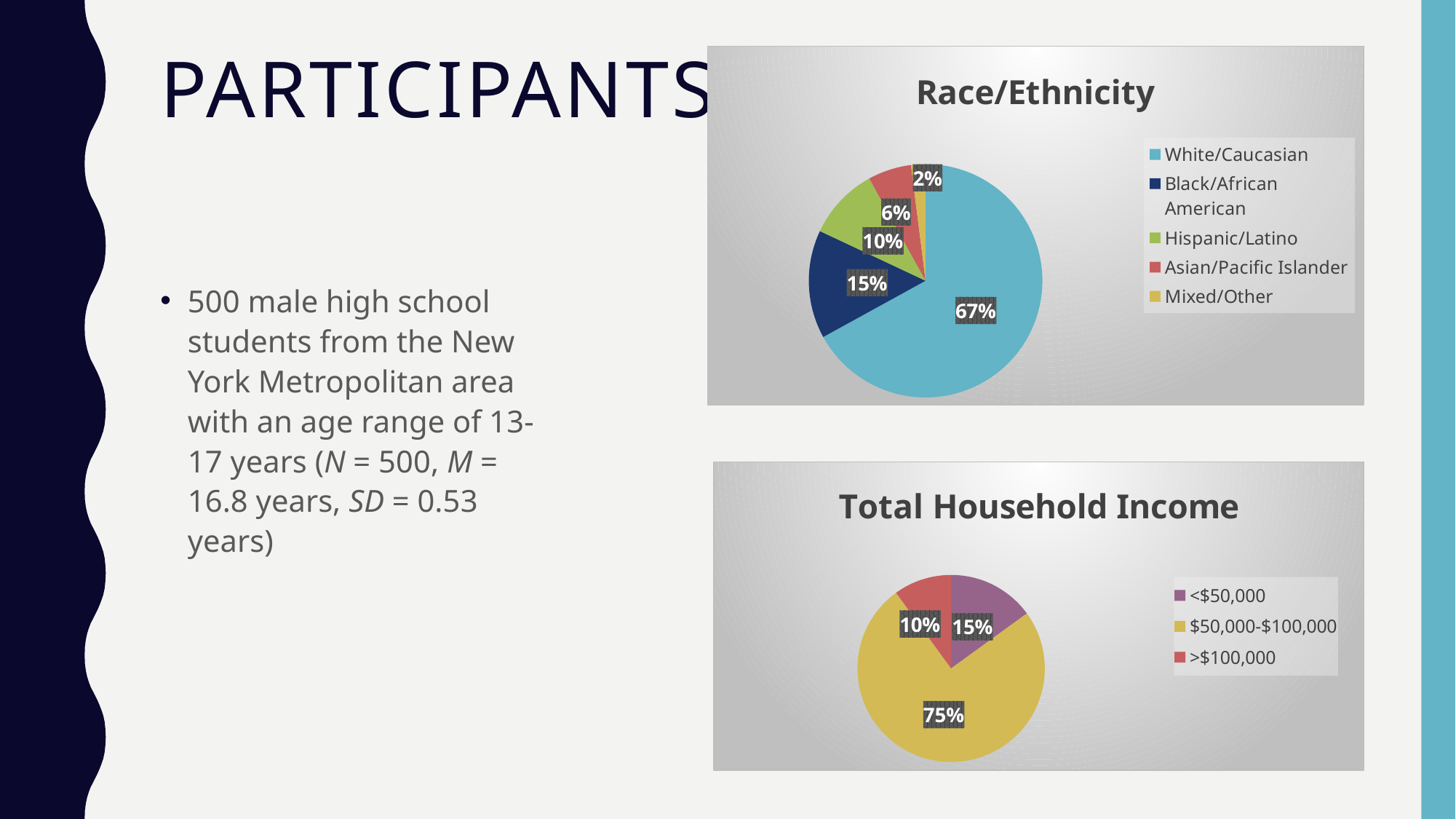
In the Total Household Income chart, what percentage is >$100,000? 10% In the Total Household Income chart, which is larger: <$50,000 or >$100,000? <$50,000 In the Total Household Income chart, what colour is the $50,000-$100,000 slice? Yellow What kind of chart is the Race/Ethnicity chart? Pie chart In the Race/Ethnicity chart, what percentage is Black/African American? 15% In the Race/Ethnicity chart, how many categories does the legend list? 5 In the Race/Ethnicity chart, what is the difference between the White/Caucasian and Black/African American shares? 52% In the Race/Ethnicity chart, what percentage is Hispanic/Latino? 10% In the Race/Ethnicity chart, which category has the smallest share? Mixed/Other In the Total Household Income chart, which category has the largest share? $50,000-$100,000 In the Race/Ethnicity chart, what percentage is White/Caucasian? 67% In the Total Household Income chart, what percentage is $50,000-$100,000? 75%